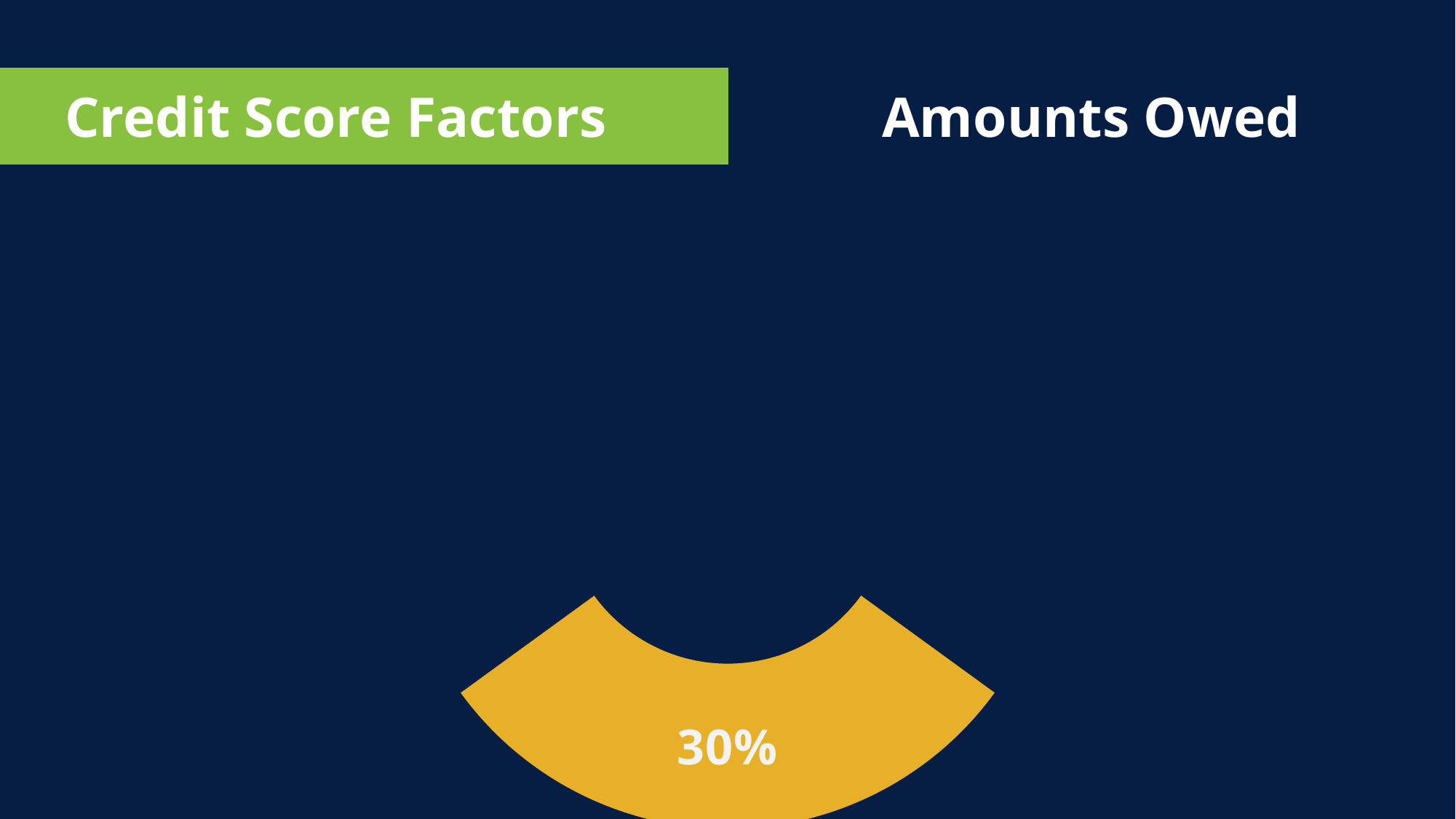
Which credit score factor does the 30% slice correspond to, according to the slide heading? Amounts Owed What colour is the slice labelled 30%? Gold (yellow-orange) What share of the whole does the visible slice labelled 30% represent? 30% What percentage is printed on the visible slice of the chart? 30% What kind of chart is shown on the slide? Doughnut chart What is the title shown in the green banner above the chart? Credit Score Factors